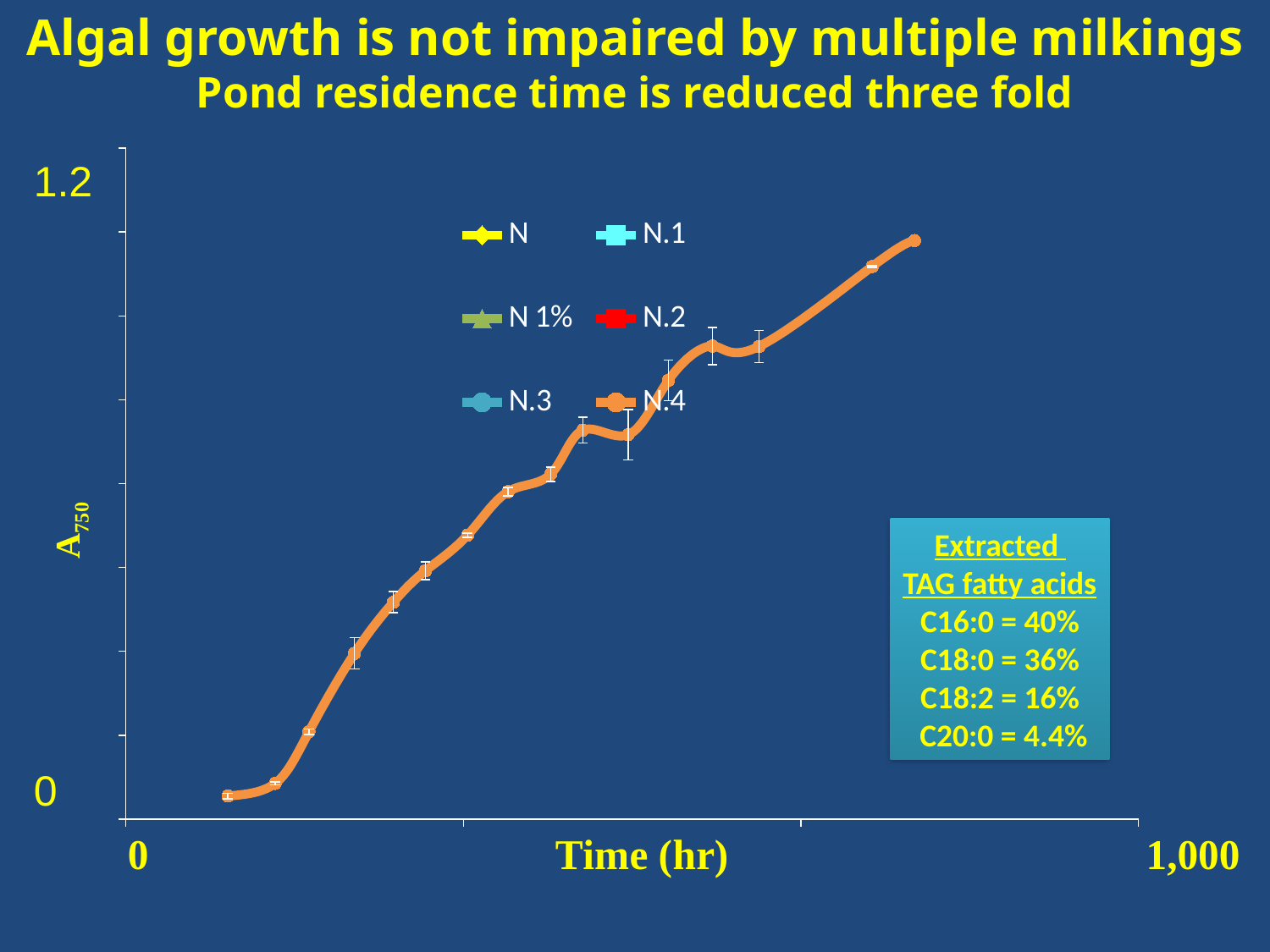
What is the maximum value shown on the y axis of the chart? 1.2 What is the label on the y axis of the chart? A750 What kind of chart is shown on the slide? line chart Do the plotted values rise or fall as time increases along the x axis? rise What is the label on the x axis of the chart? Time (hr) Is the time of the last plotted point greater or less than 1,000 hr? less How many series does the chart's legend list? 6